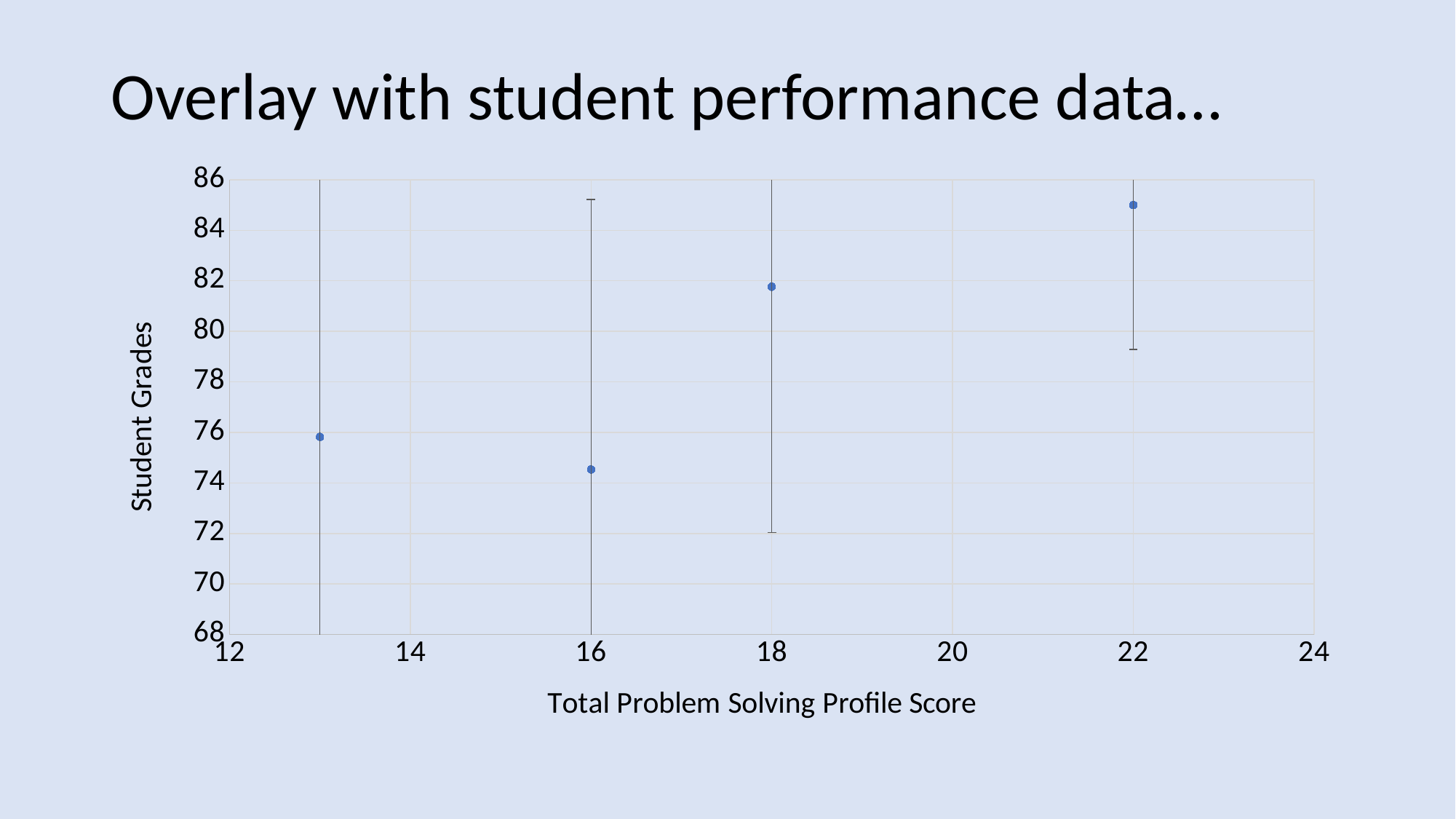
Is the Student Grades value at a profile score of 18 greater or less than 80? greater What is the label of the vertical axis? Student Grades What is the label of the horizontal axis? Total Problem Solving Profile Score Which has the higher Student Grades value: the point at a profile score of 22 or the point at 16? 22 At which Total Problem Solving Profile Score is the plotted Student Grades value lowest? 16 Is the Student Grades value at a profile score of 13 greater or less than 74? greater What kind of chart is shown on the slide? scatter chart At which Total Problem Solving Profile Score is the plotted Student Grades value highest? 22 Is the Student Grades value at a profile score of 16 greater or less than 76? less How many data points are plotted on the chart? 4 Which has the higher Student Grades value: the point at a profile score of 18 or the point at 13? 18